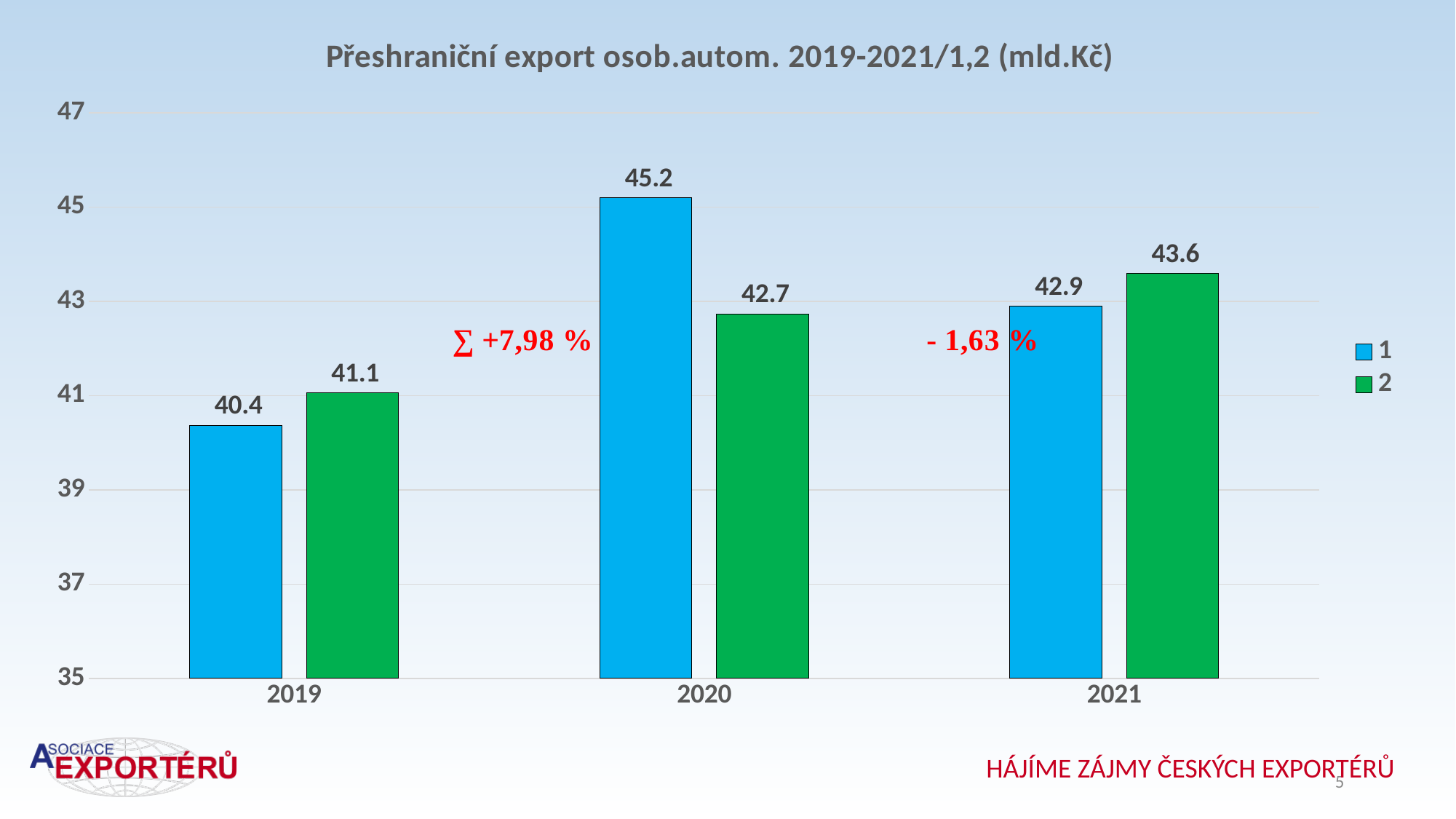
Is the value of series 1 for 2019 greater or less than 41? less How many years are shown on the x axis? 3 What is the value of series 2 for 2020? 42.7 What kind of chart is shown on the slide? bar chart Which is larger in 2021, series 1 or series 2? 2 Which year has the lowest value for series 2? 2019 What is the value of series 1 for 2019? 40.4 How many series does the legend list? 2 What is the title of the chart? Přeshraniční export osob.autom. 2019-2021/1,2 (mld.Kč) What is the difference between series 1 and series 2 in 2020? 2.5 Which year has the highest value for series 1? 2020 What is the value of series 2 for 2021? 43.6